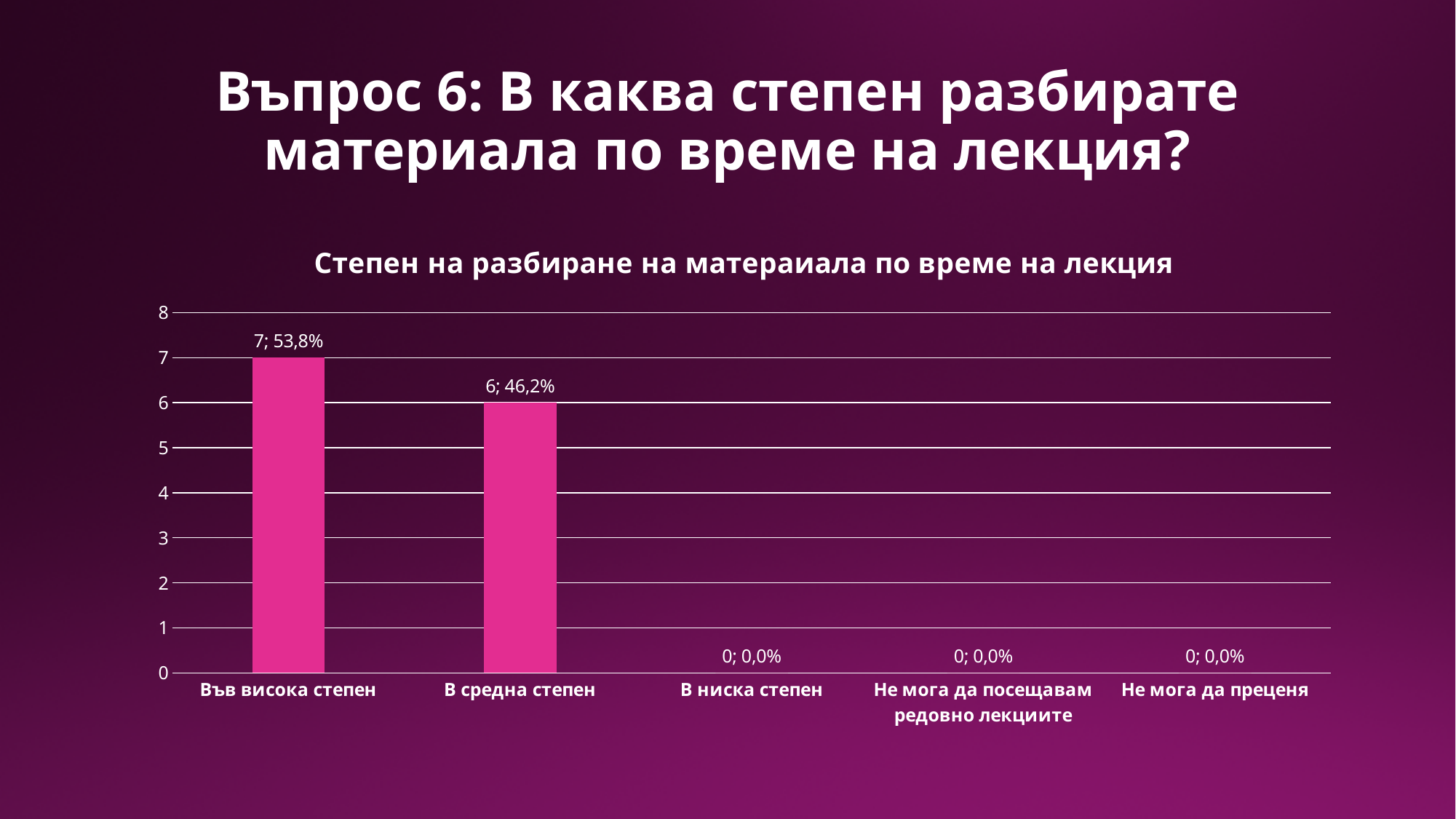
What is the value for "В ниска степен"? 0; 0,0% What is the value for "Във висока степен"? 7; 53,8% What is the value for "Не мога да преценя"? 0; 0,0% Which is larger, the value for "Във висока степен" or "В средна степен"? Във висока степен What is the title of the chart? Степен на разбиране на матераиала по време на лекция Which category has the highest value? Във висока степен How many categories are shown on the x axis? 5 What is the total count across all categories? 13 What is the value for "В средна степен"? 6; 46,2% What is the difference in count between "Във висока степен" and "В средна степен"? 1 How many categories have a value of 0? 3 What kind of chart is this? bar chart